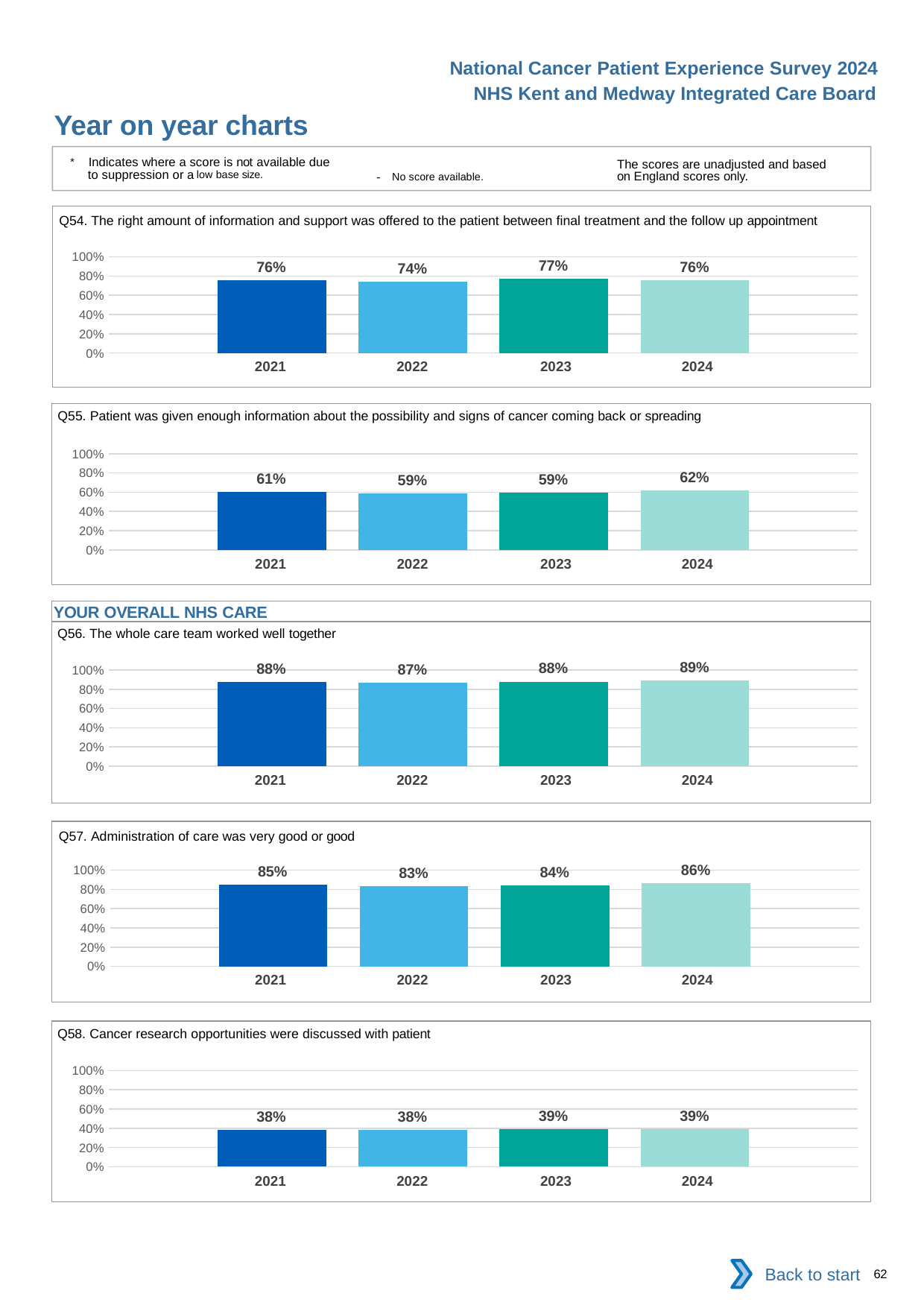
In the Q56 chart, which year has the lowest value? 2022 In the Q58 chart, is the value for 2021 greater or less than 40%? less How many years are shown in the Q54 chart? 4 What kind of chart is the Q58 chart? bar chart In the Q57 chart, what is the difference between the 2024 and 2021 values? 1% In the Q54 chart, what is the value for 2023? 77% In the Q55 chart, which year has the highest value? 2024 In the Q55 chart, what is the difference between the 2024 and 2022 values? 3% In the Q58 chart, what is the value for 2024? 39% How many charts are on the slide? 5 In the Q57 chart, which is larger, the value for 2021 or the value for 2022? 2021 In the Q56 chart, what is the value for 2022? 87%